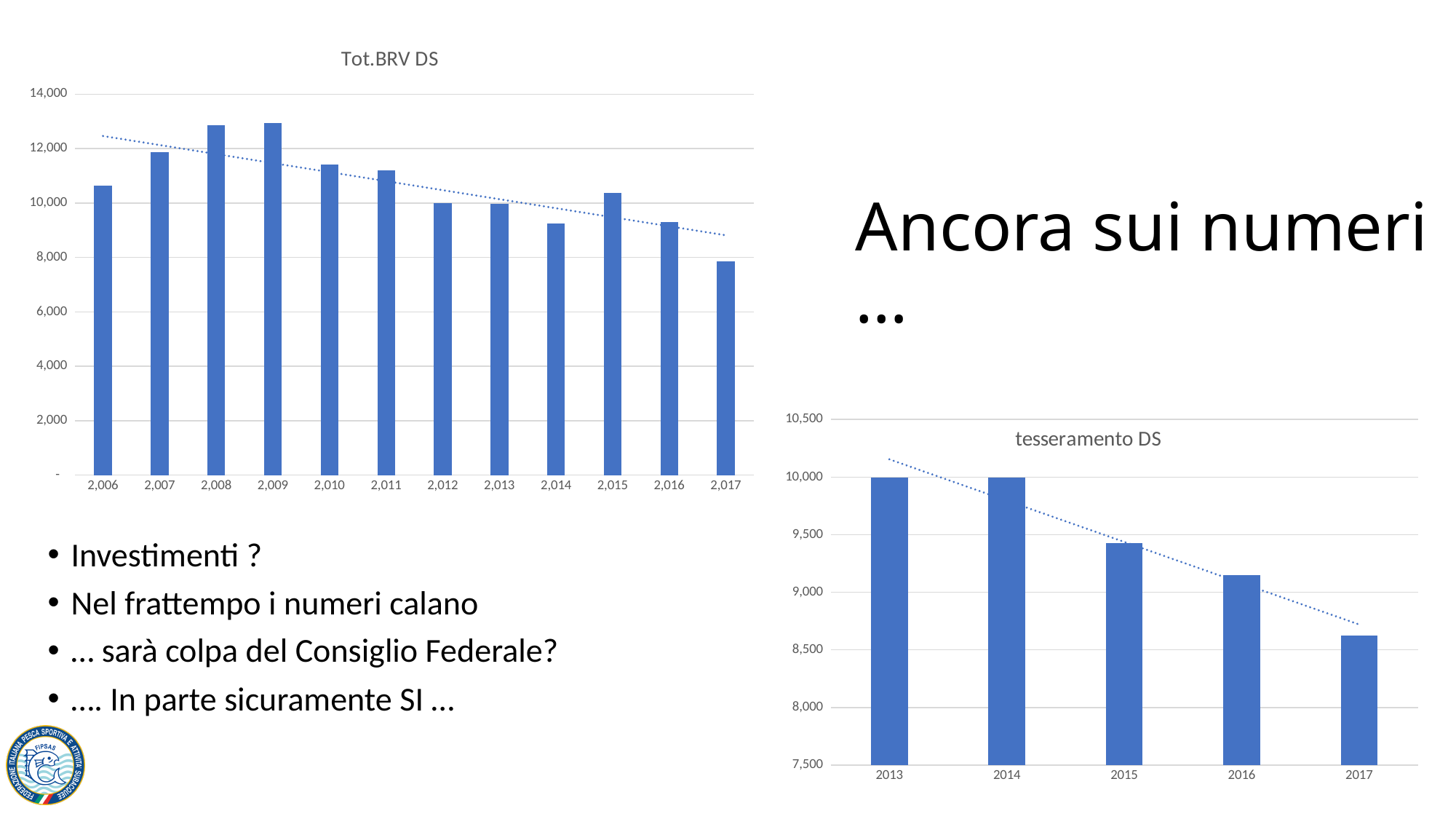
In the 'Tot.BRV DS' chart, do the values generally rise or fall from 2,006 to 2,017? fall How many years are shown on the x axis of the 'tesseramento DS' chart? 5 In the 'Tot.BRV DS' chart, which is larger, the value for 2,014 or the value for 2,015? 2,015 In the 'Tot.BRV DS' chart, is the value for 2,008 greater or less than 12,000? greater In the 'tesseramento DS' chart, which is larger, the value for 2015 or the value for 2016? 2015 What is the title of the chart in the lower right of the slide? tesseramento DS How many years are shown on the x axis of the 'Tot.BRV DS' chart? 12 In the 'tesseramento DS' chart, is the value for 2017 greater or less than 8,500? greater What kind of chart is the 'Tot.BRV DS' chart? bar chart In the 'Tot.BRV DS' chart, which year has the lowest value? 2,017 In the 'Tot.BRV DS' chart, is the value for 2,017 greater or less than 8,000? less In the 'tesseramento DS' chart, which year has the lowest value? 2017